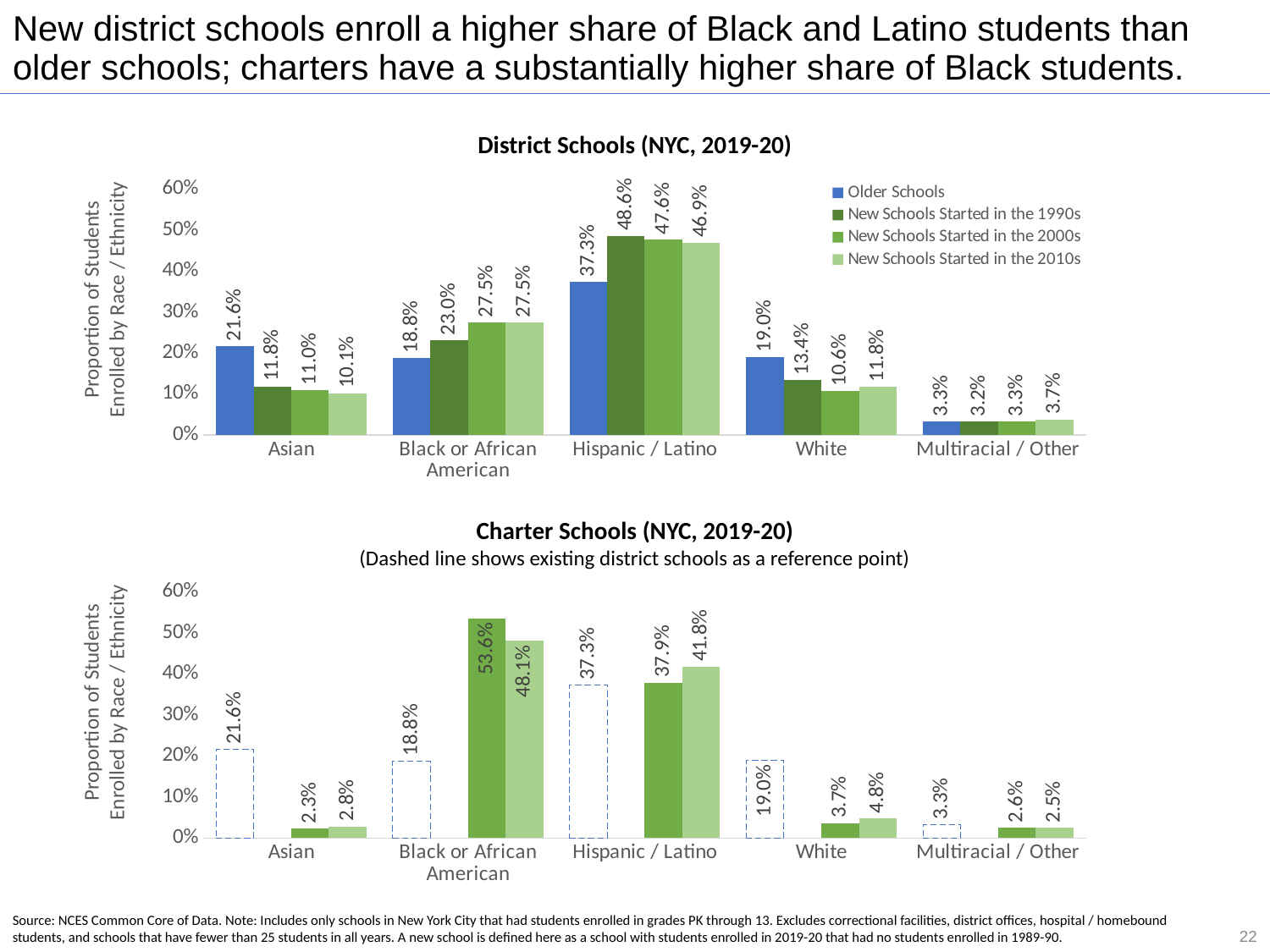
In the Charter Schools (NYC, 2019-20) chart, what is the highest value shown for the Black or African American category? 53.6% In the District Schools (NYC, 2019-20) chart, which category has the highest value for Older Schools? Hispanic / Latino In the District Schools (NYC, 2019-20) chart, what is the value for New Schools Started in the 2010s in the White category? 11.8% According to the subtitle of the Charter Schools (NYC, 2019-20) chart, what does the dashed line show? Existing district schools as a reference point In the District Schools (NYC, 2019-20) chart, what is the value for New Schools Started in the 1990s in the Hispanic / Latino category? 48.6% What kind of chart is the Charter Schools (NYC, 2019-20) chart? Bar chart In the Charter Schools (NYC, 2019-20) chart, which is larger: the 37.9% bar or the 41.8% bar in the Hispanic / Latino category? 41.8% In the District Schools (NYC, 2019-20) chart, what is the difference between the Older Schools value and the New Schools Started in the 2000s value in the Black or African American category? 8.7% In the District Schools (NYC, 2019-20) chart, what is the value for Older Schools in the Asian category? 21.6% In the District Schools (NYC, 2019-20) chart, how many series does the legend list? 4 In the District Schools (NYC, 2019-20) chart, how many categories are shown on the x axis? 5 In the Charter Schools (NYC, 2019-20) chart, what value does the dashed reference bar show for the White category? 19.0%